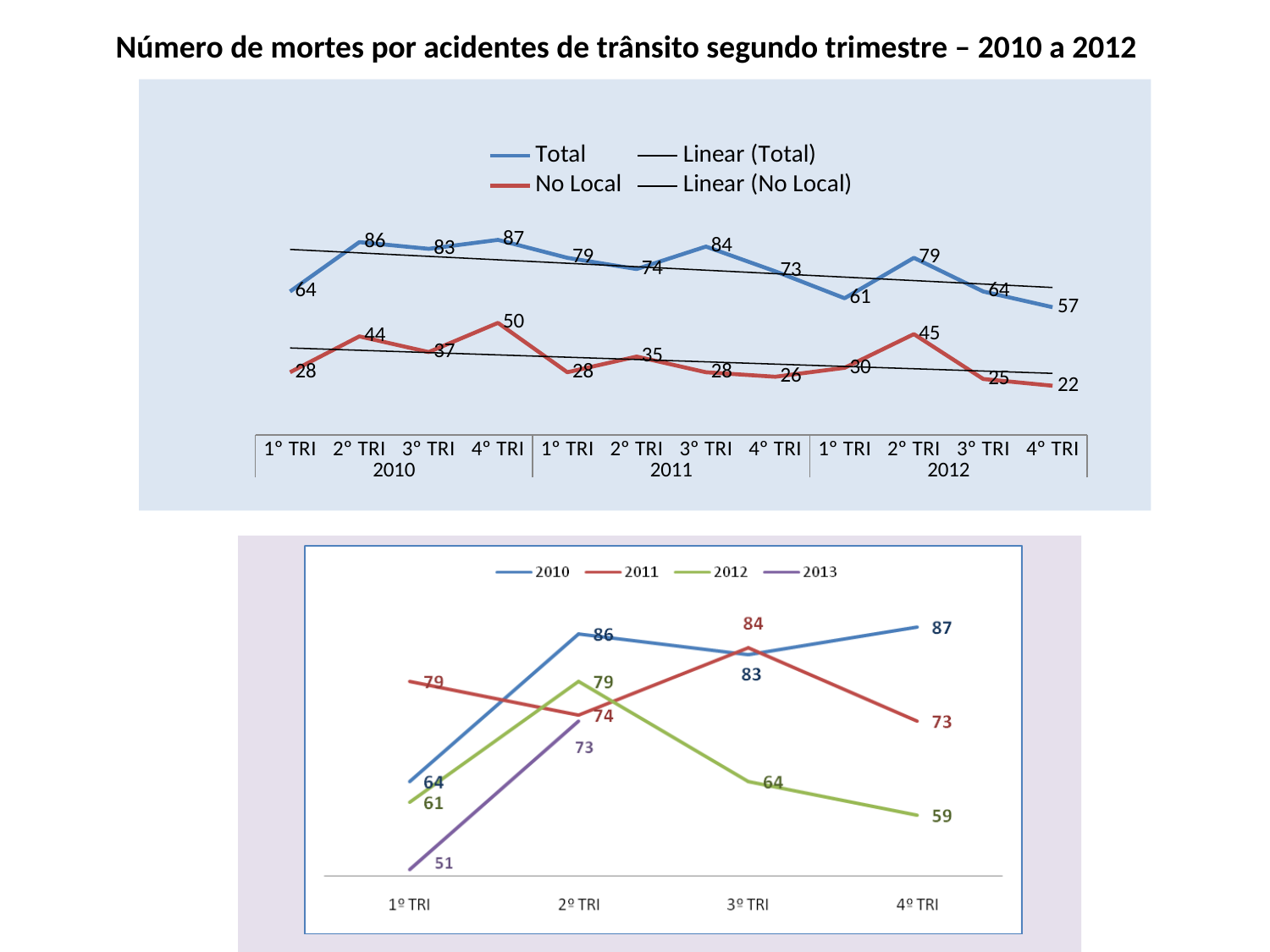
In the top chart, what is the Total value for 4° TRI of 2010? 87 What type of chart is the bottom chart? line chart In the top chart, what is the No Local value for 2° TRI of 2012? 45 In the top chart, does the Total series generally rise or fall across the quarters from 2010 to 2012? fall In the bottom chart, what is the difference between the 2010 and 2012 values in 4º TRI? 28 In the top chart, which quarter has the highest No Local value? 4° TRI 2010 In the bottom chart, which year has the highest value in 3º TRI? 2011 In the top chart, which quarter has the lowest Total value? 4° TRI 2012 In the bottom chart, how many quarters are shown on the x axis? 4 In the bottom chart, what is the value for 2013 in 2º TRI? 73 In the top chart, what is the difference between the Total and No Local values for 1° TRI of 2011? 51 In the top chart, how many series does the legend list? 4